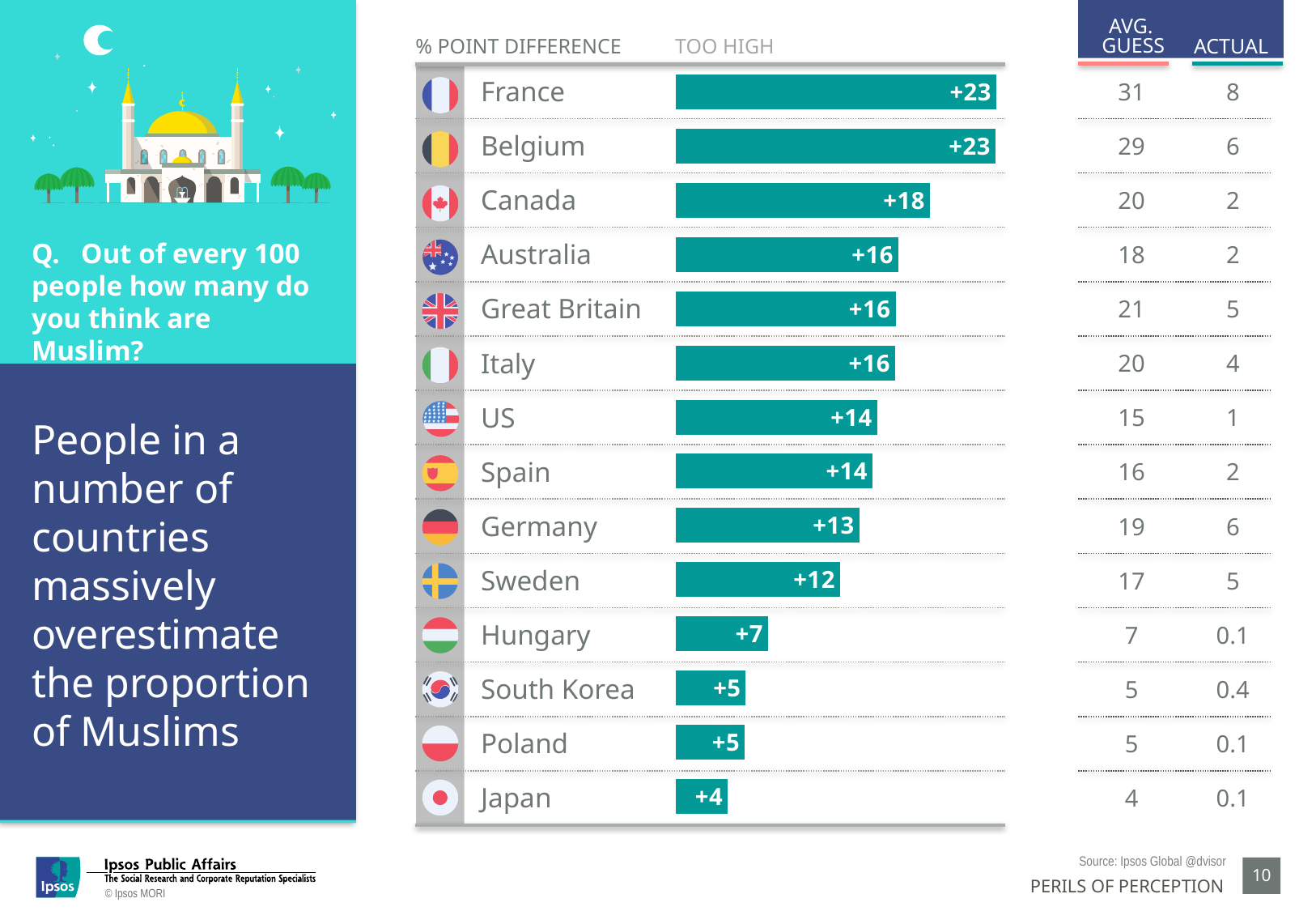
Which has a larger % point difference, Australia or Hungary? Australia What kind of chart is used to show the % point difference? Bar chart Which country has the lowest % point difference? Japan Do the % point difference values rise or fall going down the list from France to Japan? Fall How many countries are shown in the chart? 14 What is the % point difference shown for Germany? +13 What is the difference between the % point difference for Canada and for Sweden? 6 What is the % point difference shown for France? +23 Which country has the highest average guess? France What is the actual value for Hungary? 0.1 What are the two column headings in the table to the right of the chart? AVG. GUESS and ACTUAL What is the average guess for Canada? 20